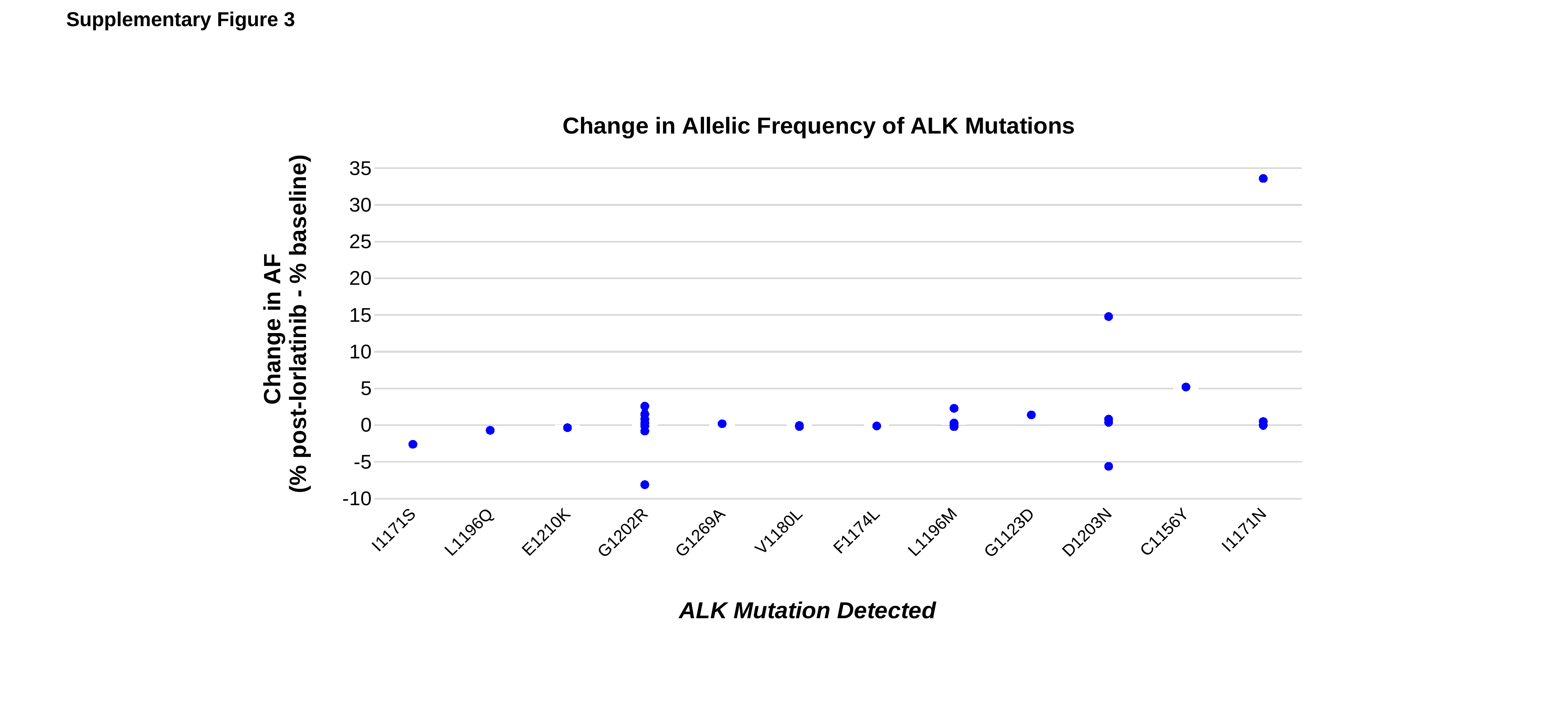
Is the lowest value for G1202R greater or less than -5? less Is the highest value for D1203N greater or less than 10? greater How many ALK mutation categories are shown on the x axis? 12 Is the value for I1171S greater or less than 0? less What is the title of the chart? Change in Allelic Frequency of ALK Mutations What is the x-axis title of the chart? ALK Mutation Detected Which mutation has the most plotted points? G1202R Which mutation has the lowest plotted change in AF? G1202R Which mutation has the highest plotted change in AF? I1171N What kind of chart is shown on the slide? Scatter chart